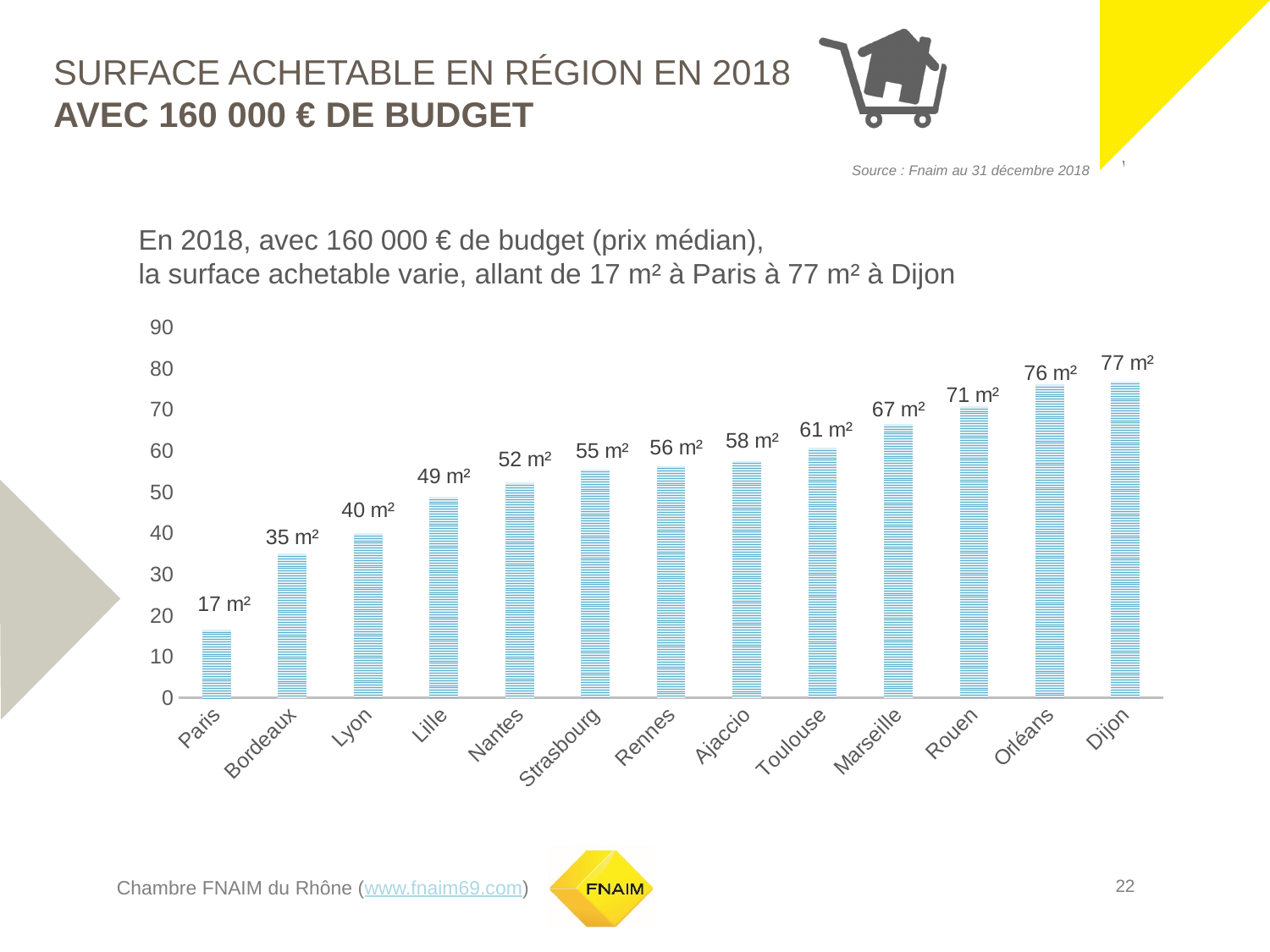
What is the value shown for Toulouse? 61 m² What kind of chart is shown on the slide? bar chart What is the difference between the values for Marseille and Bordeaux? 32 m² Which has a larger value, Nantes or Rouen? Rouen Which city has the lowest purchasable surface area? Paris Is the value for Lille greater or less than 50? less Do the values rise or fall from left to right along the x axis? rise Which city has the highest purchasable surface area? Dijon How many cities are shown in the chart? 13 What is the difference between the values for Dijon and Paris? 60 m² What is the purchasable surface area shown for Lyon? 40 m² What is the source cited for the chart data? Fnaim au 31 décembre 2018